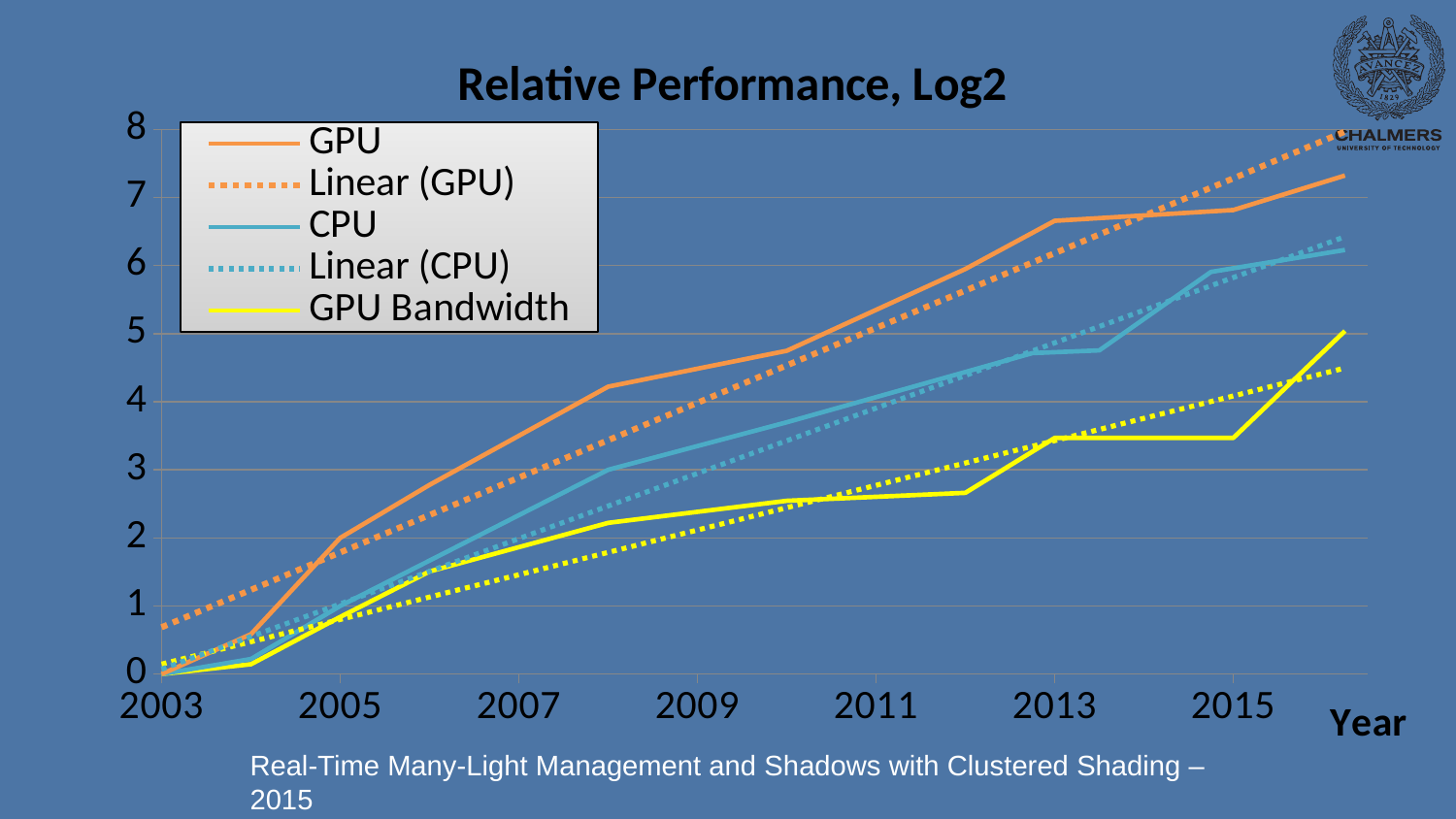
Is the GPU value for 2009 greater or less than 4? greater What kind of chart is shown on the slide? line chart What is the title of the chart? Relative Performance, Log2 Which series has the highest value in 2015? GPU Is the GPU Bandwidth value for 2009 greater or less than 2? greater Does the GPU series rise or fall from 2003 to 2015? rise What is the label of the x axis? Year Is the CPU value for 2013 greater or less than 4? greater How many series does the legend list? 5 Which is larger in 2013, the GPU value or the CPU value? GPU